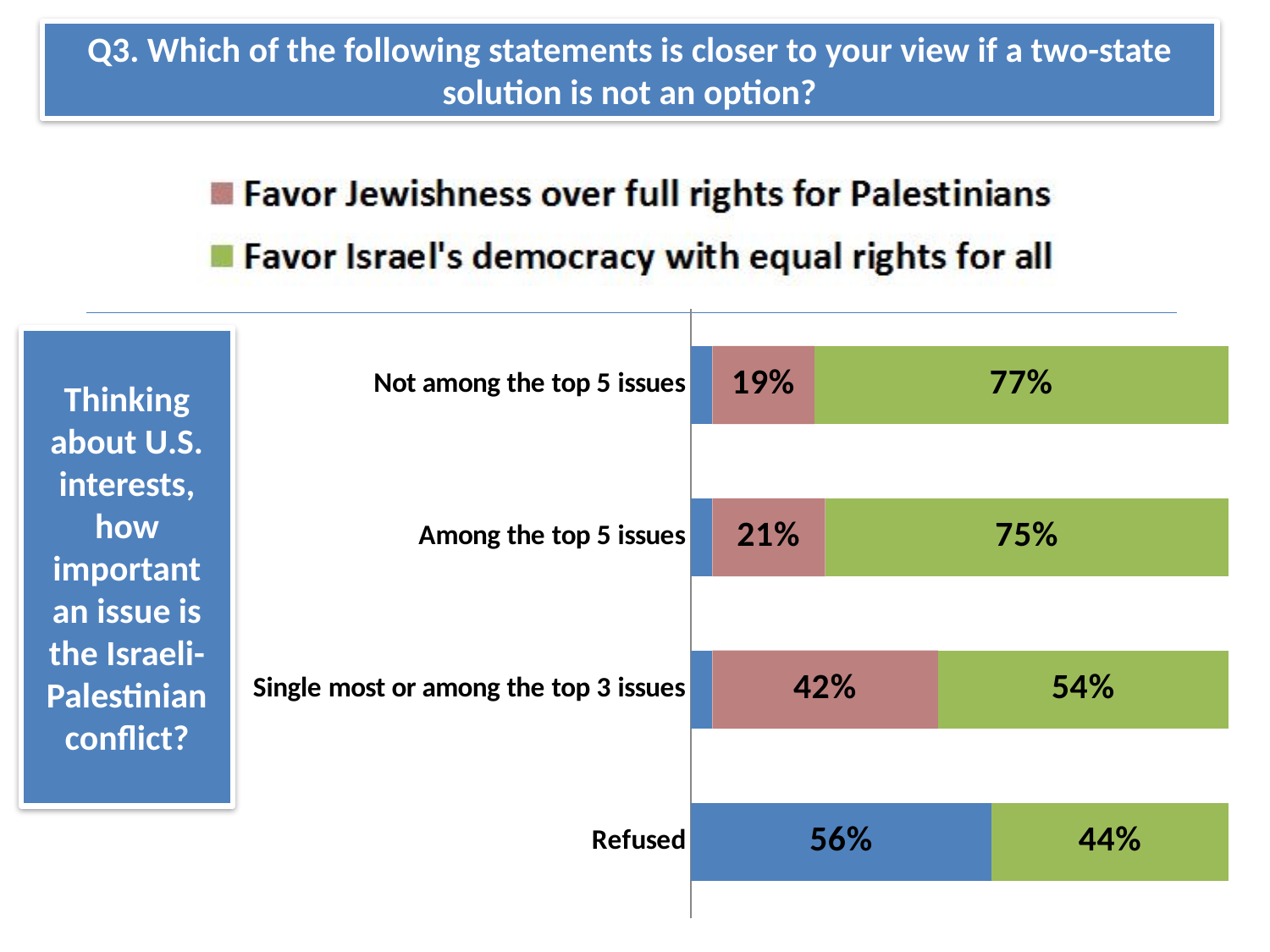
Which category has a larger value for 'Favor Israel's democracy with equal rights for all': 'Among the top 5 issues' or 'Single most or among the top 3 issues'? Among the top 5 issues How many categories are shown on the chart? 4 Which category has the lowest value for 'Favor Israel's democracy with equal rights for all'? Refused Which category has the highest value for 'Favor Jewishness over full rights for Palestinians'? Single most or among the top 3 issues What percentage favor Israel's democracy with equal rights for all among those who say the conflict is not among the top 5 issues? 77% How many series does the legend list? 2 In the 'Single most or among the top 3 issues' category, what is the difference between the 'Favor Israel's democracy' value and the 'Favor Jewishness' value? 12 percentage points In the 'Not among the top 5 issues' category, how many percentage points higher is 'Favor Israel's democracy with equal rights for all' than 'Favor Jewishness over full rights for Palestinians'? 58 percentage points What is the value for 'Favor Israel's democracy with equal rights for all' in the 'Refused' category? 44% What is the value for 'Favor Jewishness over full rights for Palestinians' in the 'Single most or among the top 3 issues' category? 42% What percentage favor Jewishness over full rights for Palestinians among those who say the conflict is among the top 5 issues? 21% What kind of chart is shown on the slide? Stacked bar chart